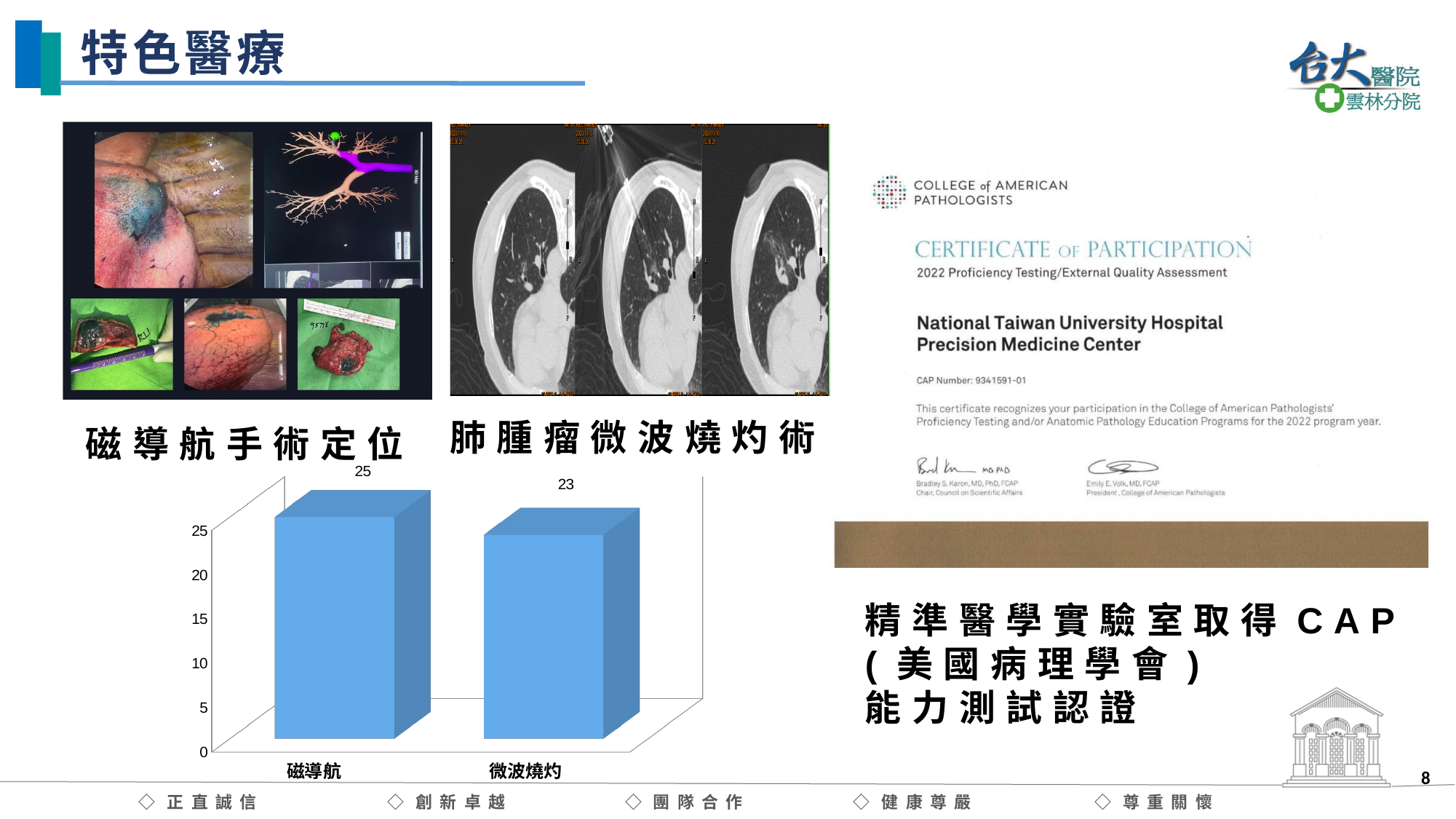
Is the value for 磁導航 in the bar chart greater or less than 20? greater What is the highest tick value shown on the vertical axis of the bar chart? 25 What kind of chart is shown on the slide? bar chart Which is larger in the bar chart, the value for 磁導航 or the value for 微波燒灼? 磁導航 What is the difference between the values for 磁導航 and 微波燒灼 in the bar chart? 2 Which category has the lowest value in the bar chart? 微波燒灼 What is the value for 磁導航 in the bar chart? 25 Is the value for 微波燒灼 in the bar chart greater or less than 20? greater What colour are the bars in the bar chart? blue How many categories are shown in the bar chart? 2 Which category has the highest value in the bar chart? 磁導航 What is the value for 微波燒灼 in the bar chart? 23